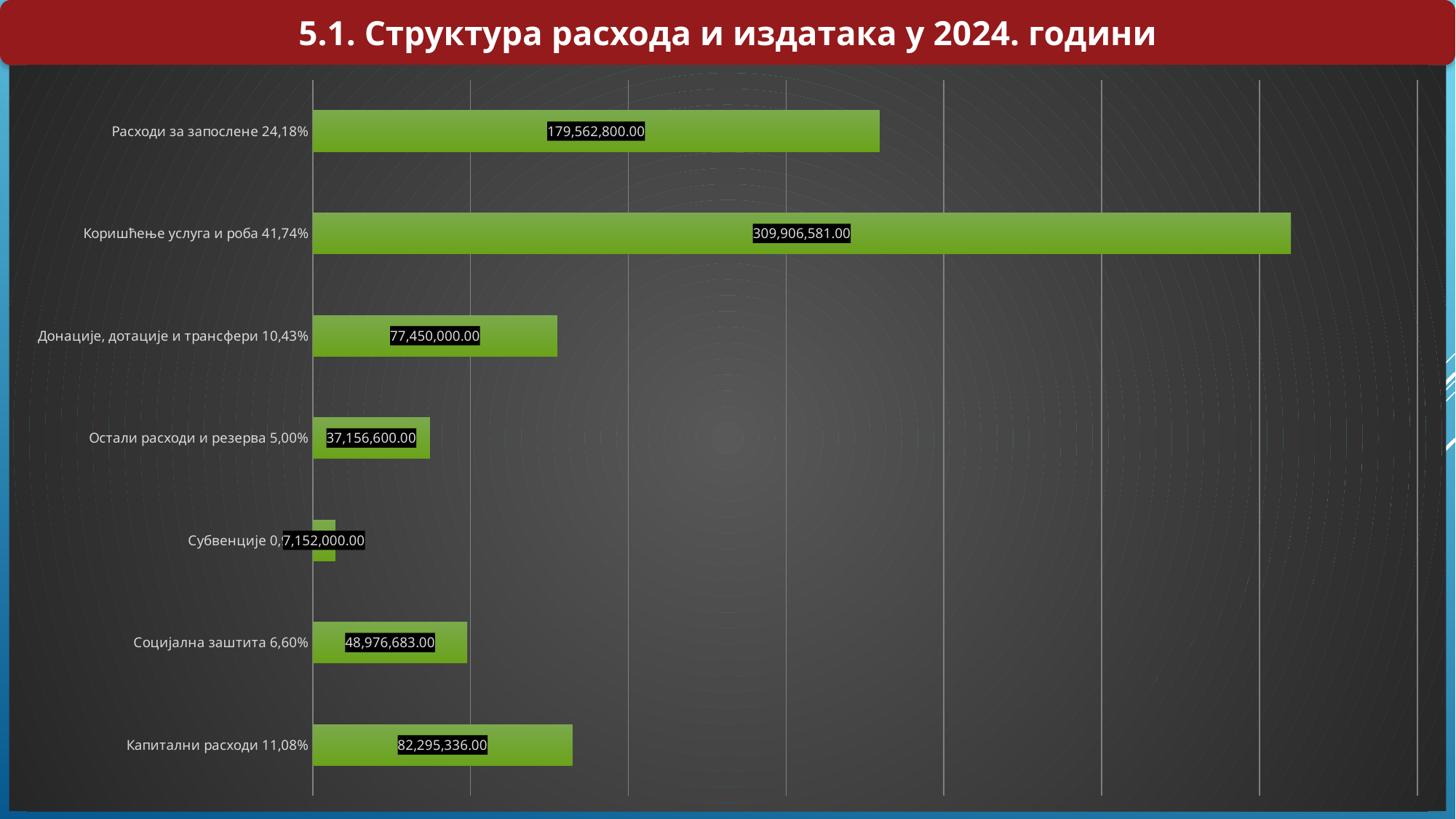
What is the value for Расходи за запослене? 179,562,800.00 What type of chart is shown on the slide? Bar chart Which category has the highest value? Коришћење услуга и роба What is the value for Коришћење услуга и роба? 309,906,581.00 What is the value for Социјална заштита? 48,976,683.00 Which is larger, the value for Капитални расходи or the value for Донације, дотације и трансфери? Капитални расходи What is the value for Донације, дотације и трансфери? 77,450,000.00 What is the value for Капитални расходи? 82,295,336.00 What is the difference between the values for Коришћење услуга и роба and Расходи за запослене? 130,343,781.00 What is the title of the slide? 5.1. Структура расхода и издатака у 2024. години How many categories are shown in the chart? 7 Which category has the lowest value? Субвенције